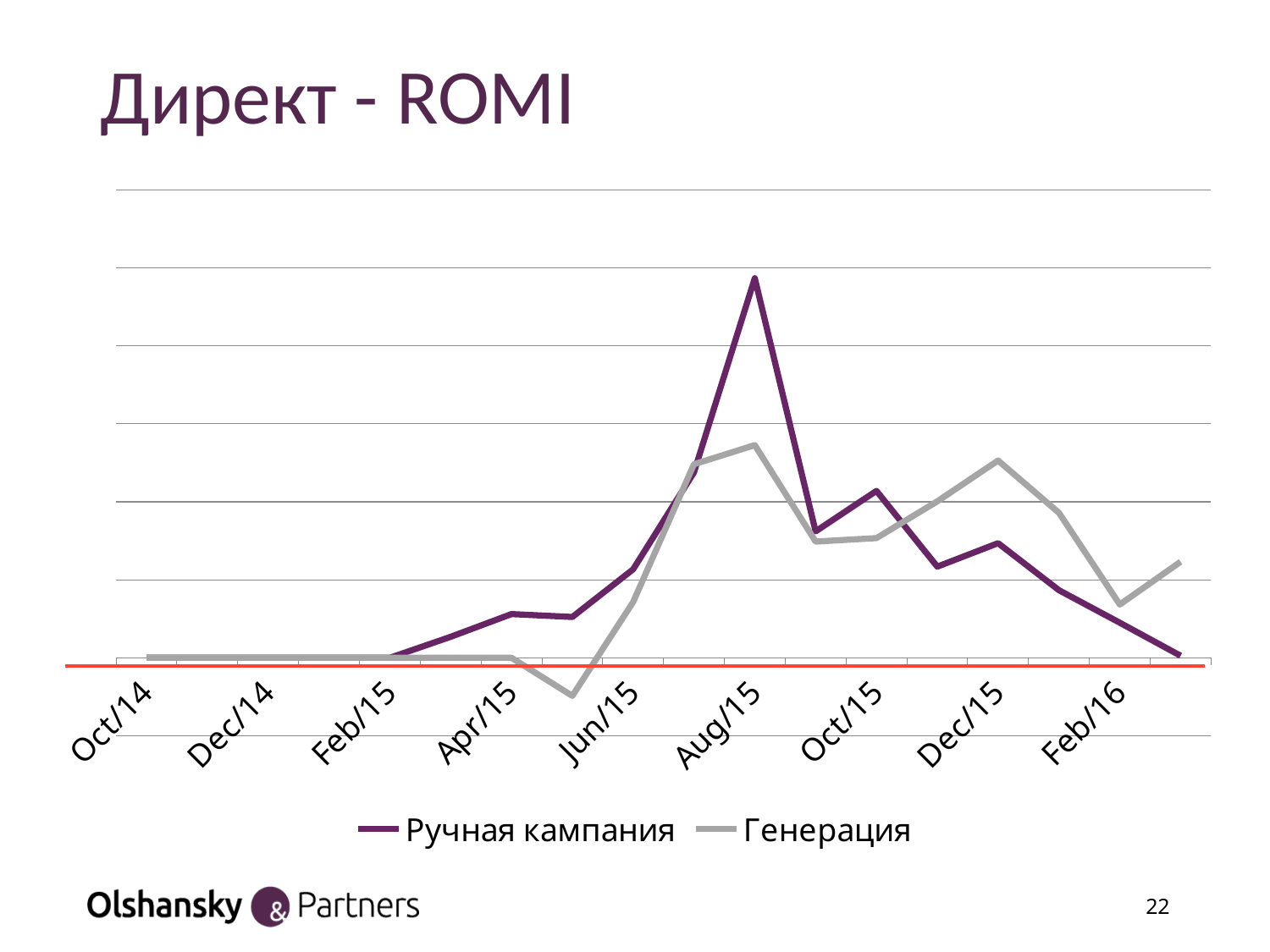
Which series is drawn in purple? Ручная кампания How many series does the legend list? 2 In which month does the Ручная кампания series reach its highest value? Aug/15 Does the Ручная кампания series rise or fall overall from Aug/15 to the end of the chart? fall What kind of chart is shown on the slide? line chart Which series dips below the baseline between Apr/15 and Jun/15? Генерация At Oct/15, which series has the higher value, Ручная кампания or Генерация? Ручная кампания How many month labels are shown on the x axis? 9 At Dec/15, which series has the higher value, Ручная кампания or Генерация? Генерация What is the title of the chart? Директ - ROMI At Aug/15, which series has the higher value, Ручная кампания or Генерация? Ручная кампания Does the Ручная кампания series rise or fall overall from Feb/15 to Aug/15? rise